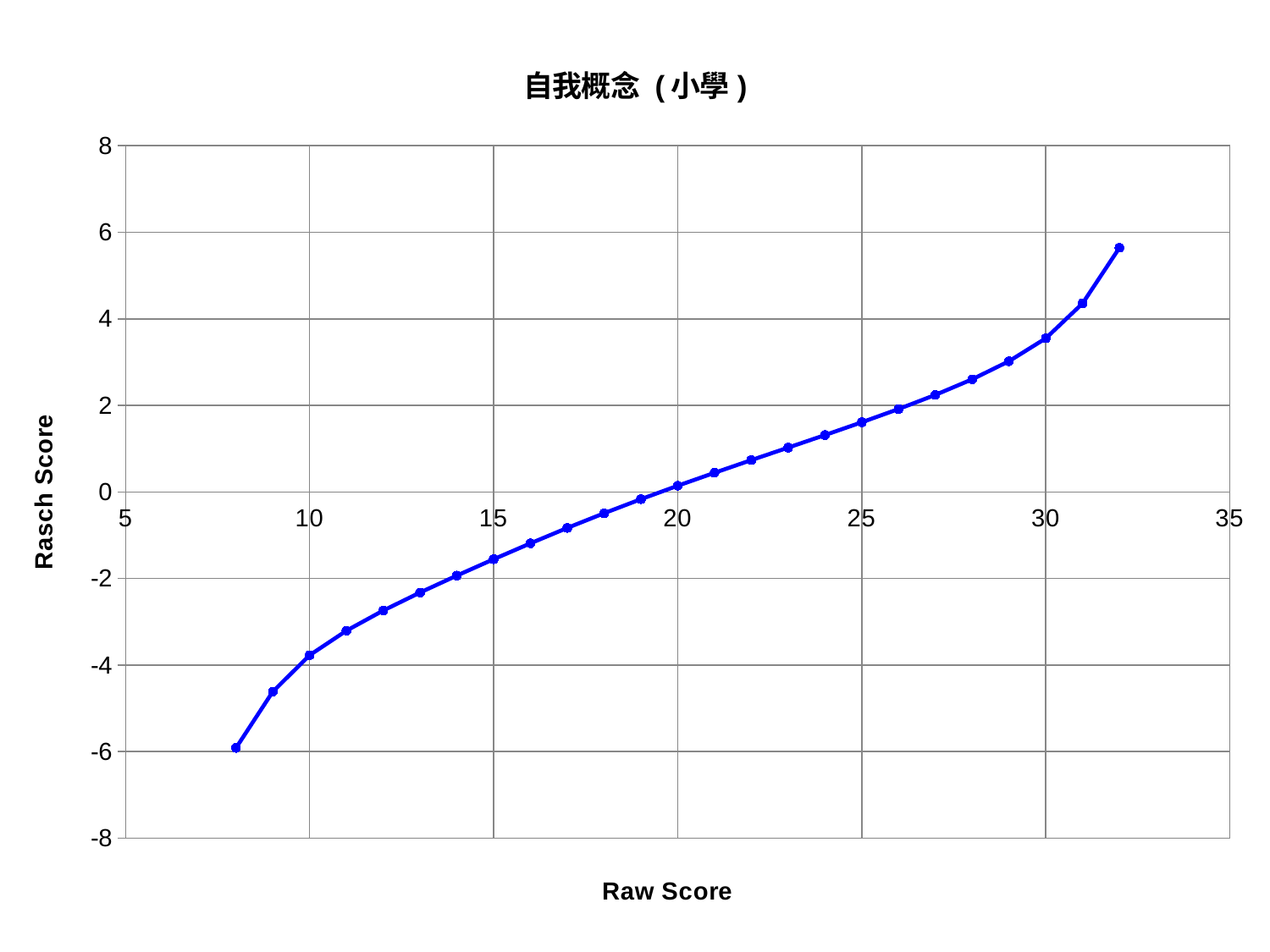
Does the Rasch Score rise or fall as the Raw Score increases? Rise Which has the larger Rasch Score, Raw Score 10 or Raw Score 25? Raw Score 25 What kind of chart is shown on the slide? Line chart Is the Rasch Score at Raw Score 30 greater or less than 2? greater At which Raw Score is the Rasch Score lowest? 8 What is the title of the chart? 自我概念（小學） At which Raw Score is the Rasch Score highest? 32 What is the label of the vertical axis? Rasch Score Is the Rasch Score at Raw Score 8 greater or less than -4? less Is the Rasch Score at Raw Score 15 greater or less than 0? less How many data points are plotted on the line? 25